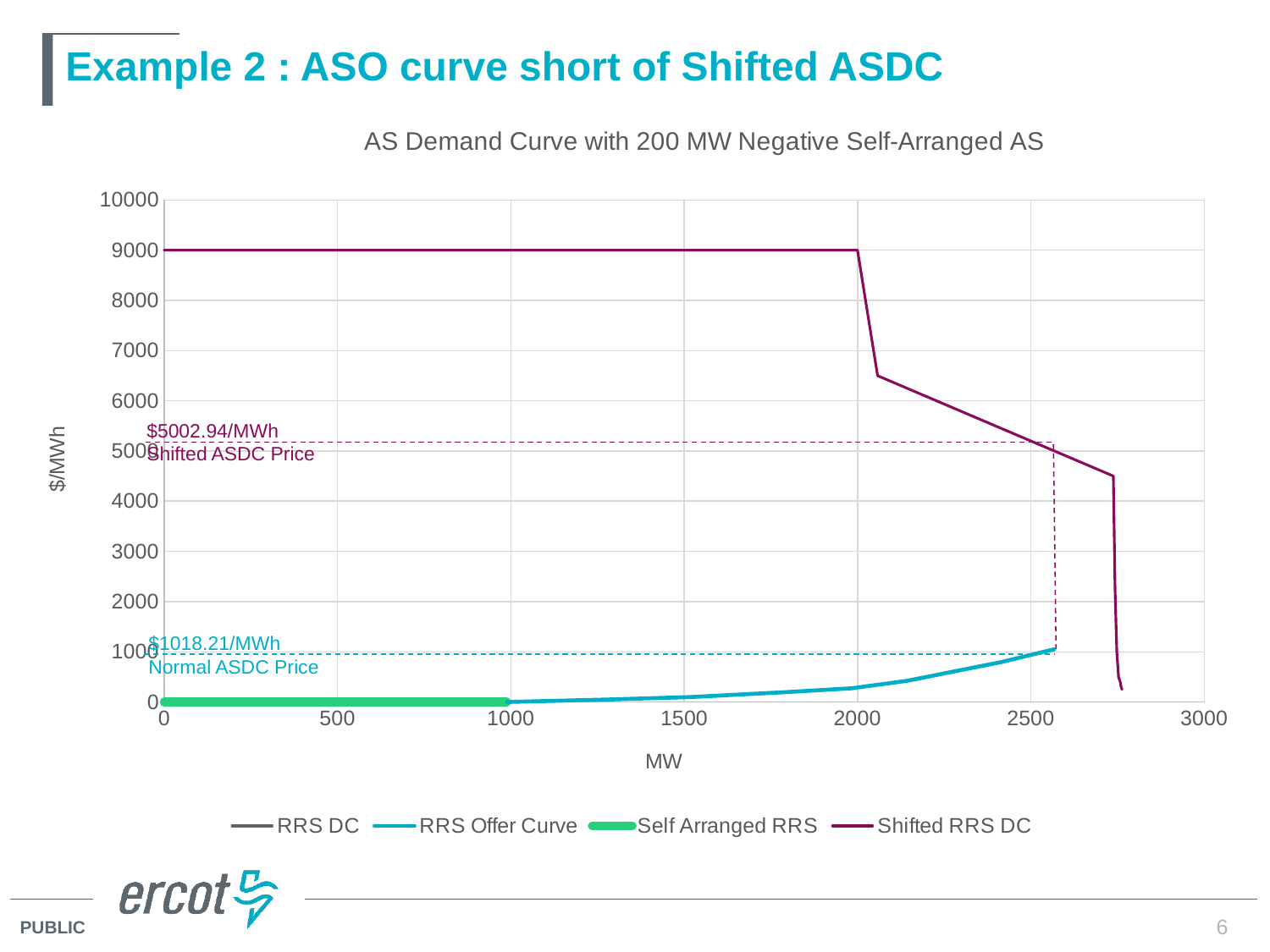
What kind of chart is shown on the slide? Line chart What is the label of the vertical axis of the chart? $/MWh How many series does the chart legend list? 4 What is the title of the chart? AS Demand Curve with 200 MW Negative Self-Arranged AS What Normal ASDC Price is annotated on the chart? $1018.21/MWh What is the value of the Shifted RRS DC series at 1500 MW? 9000 Which annotated price is larger, the Shifted ASDC Price or the Normal ASDC Price? Shifted ASDC Price Is the value of the Shifted RRS DC series at 2500 MW greater or less than 6000? less What is the difference between the annotated Shifted ASDC Price and the Normal ASDC Price? $3984.73/MWh Is the value of the RRS Offer Curve at 2000 MW greater or less than 1000? less What Shifted ASDC Price is annotated on the chart? $5002.94/MWh Does the RRS Offer Curve rise or fall as MW increases from 1000 to 2500? rise